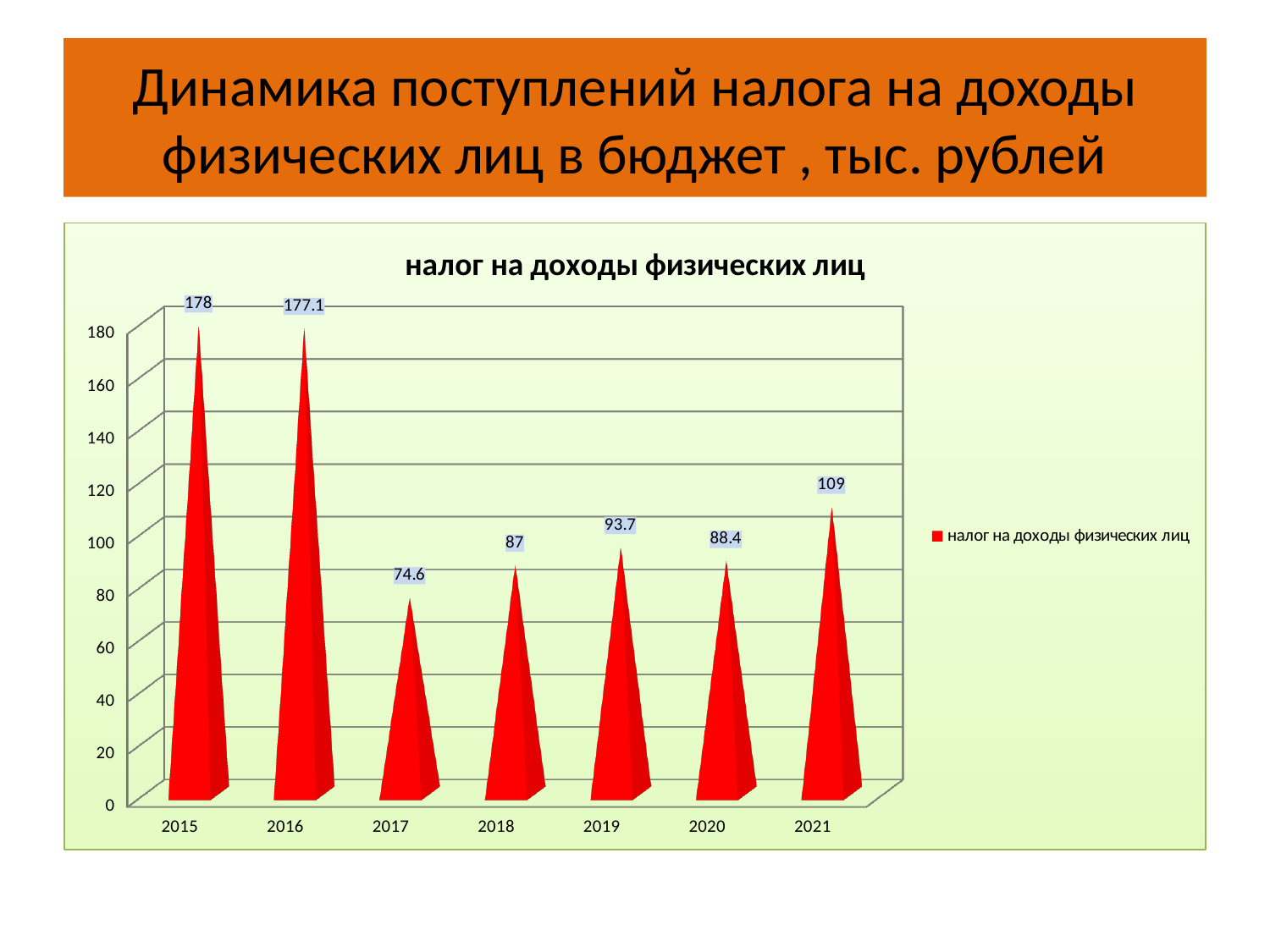
How many years are shown on the x axis? 7 Which year has the lowest value? 2017 What is the difference between the values for 2021 and 2020? 20.6 Which year has the highest value? 2015 What is the value for 2017? 74.6 How many series does the legend list? 1 What is the difference between the values for 2015 and 2016? 0.9 What kind of chart is shown? bar chart Which is larger, the value for 2019 or the value for 2020? 2019 What is the title of the chart? налог на доходы физических лиц What is the value for 2015? 178 What is the value for 2021? 109